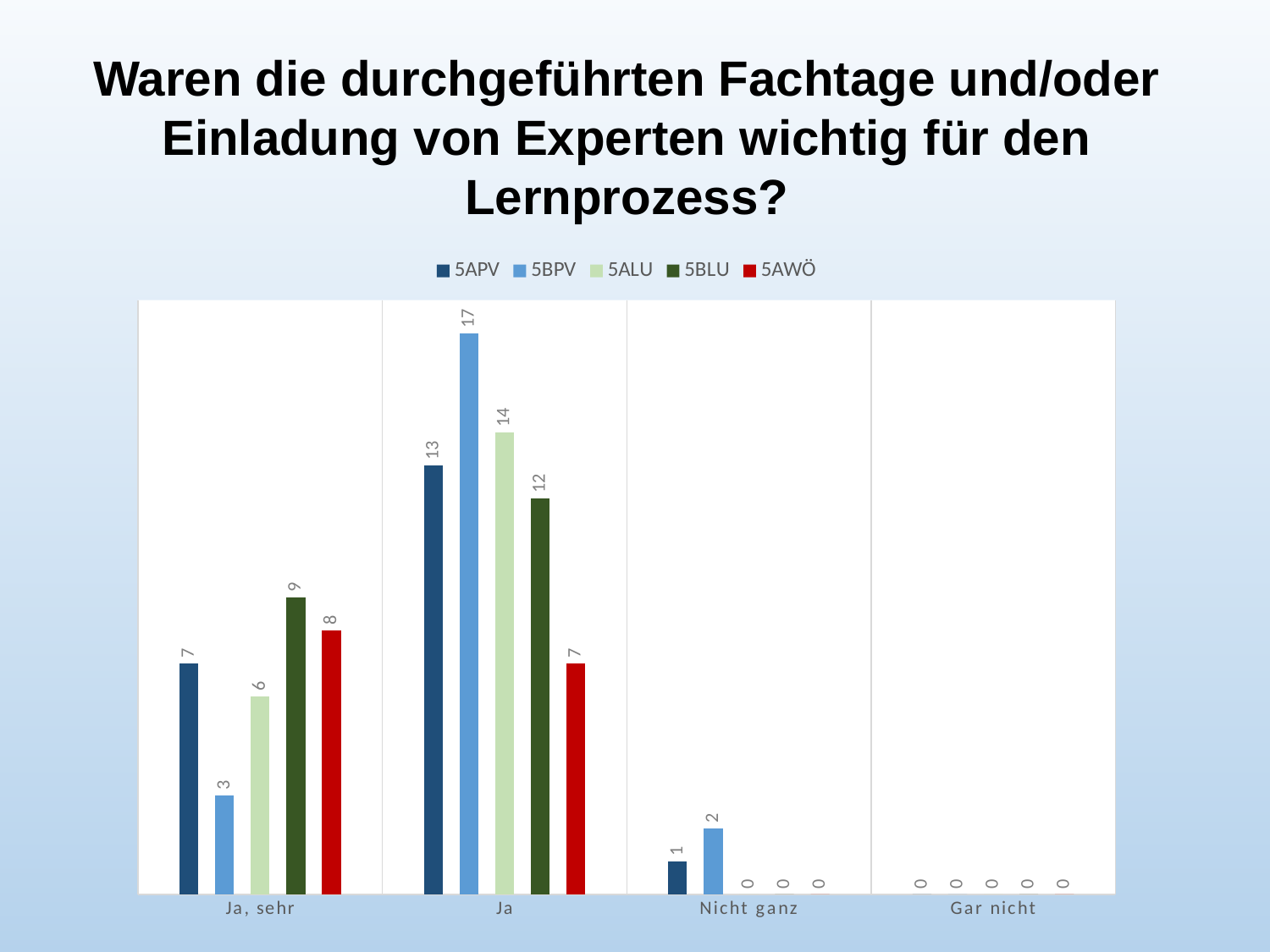
How many series does the legend list? 5 Which series has the highest value in the "Ja" category? 5BPV Which is larger: the 5BLU value for "Ja, sehr" or the 5ALU value for "Ja, sehr"? 5BLU What value does 5APV have for the category "Nicht ganz"? 1 What is the total of all five series in the "Gar nicht" category? 0 What kind of chart is shown on the slide? bar chart Which series is shown in red in the legend? 5AWÖ What value does 5AWÖ have for the category "Ja, sehr"? 8 What is the difference between the 5BPV and 5APV values in the "Ja" category? 4 How many categories are shown on the x axis? 4 Which series has the lowest value in the "Ja, sehr" category? 5BPV What value does 5BPV have for the category "Ja"? 17